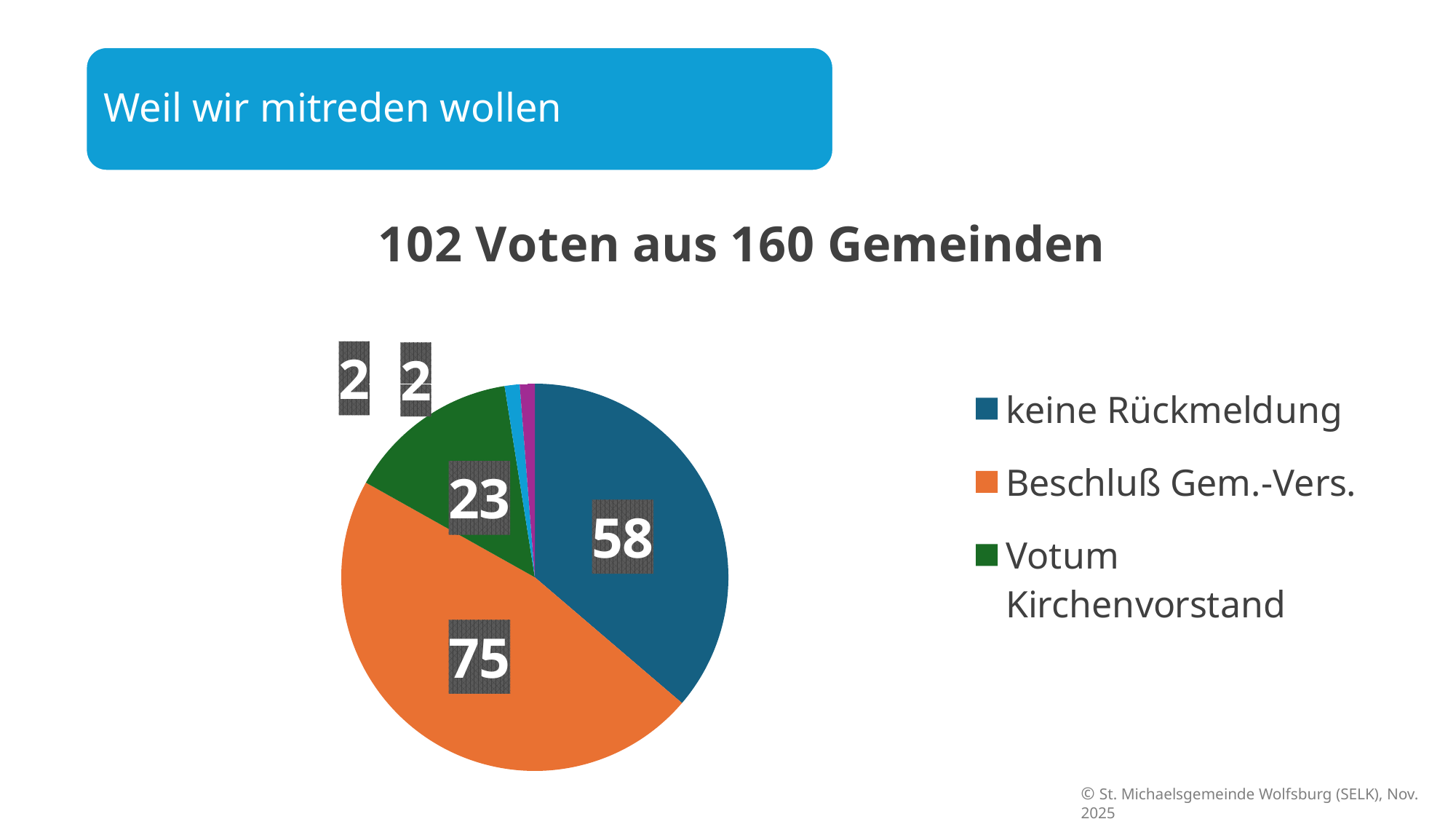
What type of chart is shown on the slide? pie chart What is the difference between the values for "Beschluß Gem.-Vers." and "keine Rückmeldung"? 17 How many entries does the legend list? 3 Which is larger, the value for "keine Rückmeldung" or the value for "Votum Kirchenvorstand"? keine Rückmeldung Which category has the largest slice of the pie? Beschluß Gem.-Vers. How many slices does the pie chart have? 5 What is the value for "keine Rückmeldung"? 58 What is the difference between the values for "keine Rückmeldung" and "Votum Kirchenvorstand"? 35 What is the title of the chart? 102 Voten aus 160 Gemeinden What is the value for "Beschluß Gem.-Vers."? 75 Which of the three legend categories has the smallest slice? Votum Kirchenvorstand What is the value for "Votum Kirchenvorstand"? 23